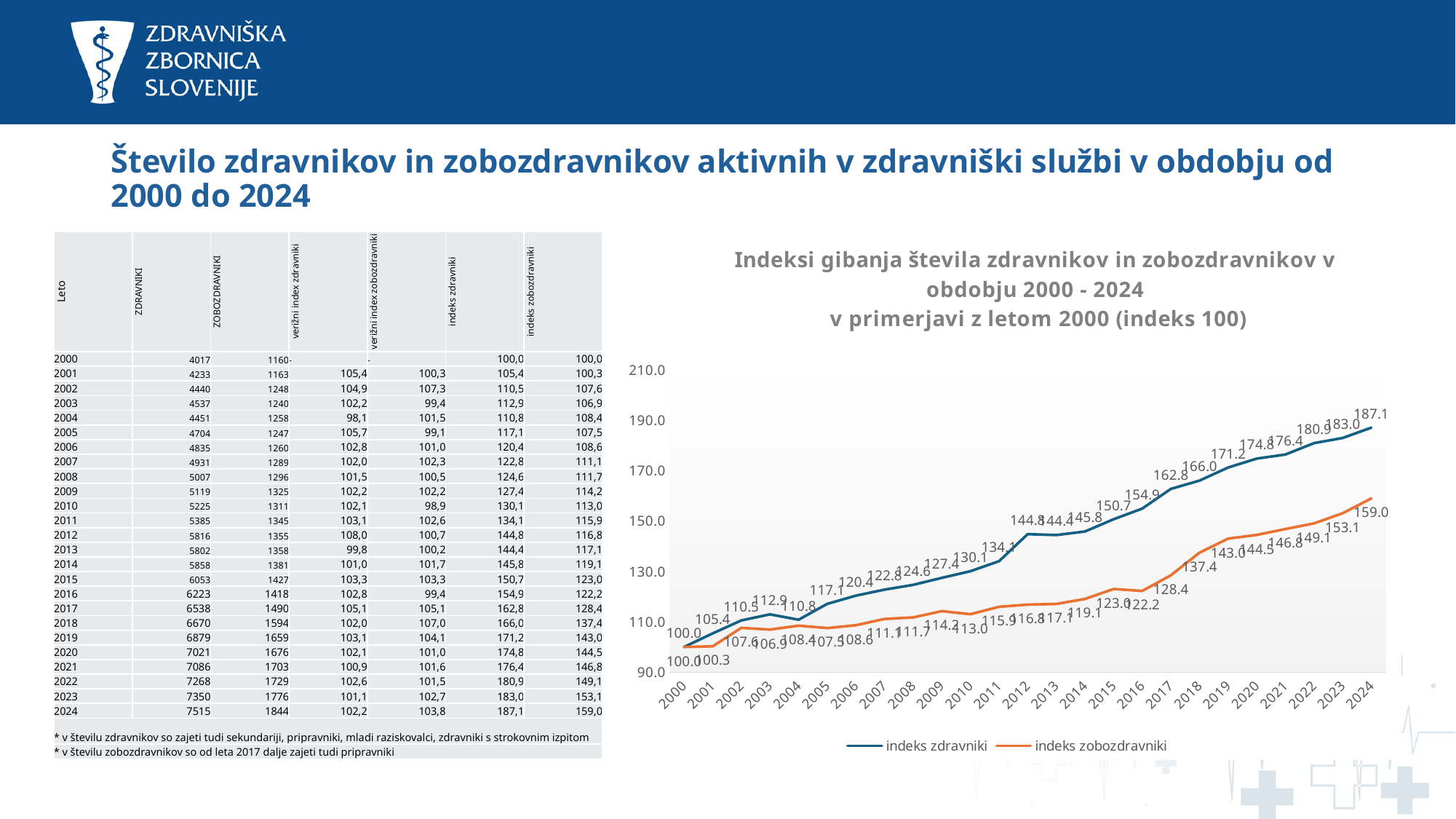
What is the value of indeks zdravniki in 2017? 162.8 How many series does the chart legend list? 2 Do the values of indeks zdravniki generally rise or fall from 2000 to 2024? rise In which year is indeks zdravniki highest? 2024 What is the difference between indeks zdravniki and indeks zobozdravniki in 2024? 28.1 Which series has the larger value in 2017, indeks zdravniki or indeks zobozdravniki? indeks zdravniki What kind of chart is shown on the slide? line chart What is the value of indeks zobozdravniki in 2024? 159.0 What is the value of indeks zdravniki in 2024? 187.1 How many years are plotted along the x axis of the chart? 25 What is the value of indeks zobozdravniki in 2018? 137.4 Is the value of indeks zobozdravniki in 2010 greater or less than 130? less